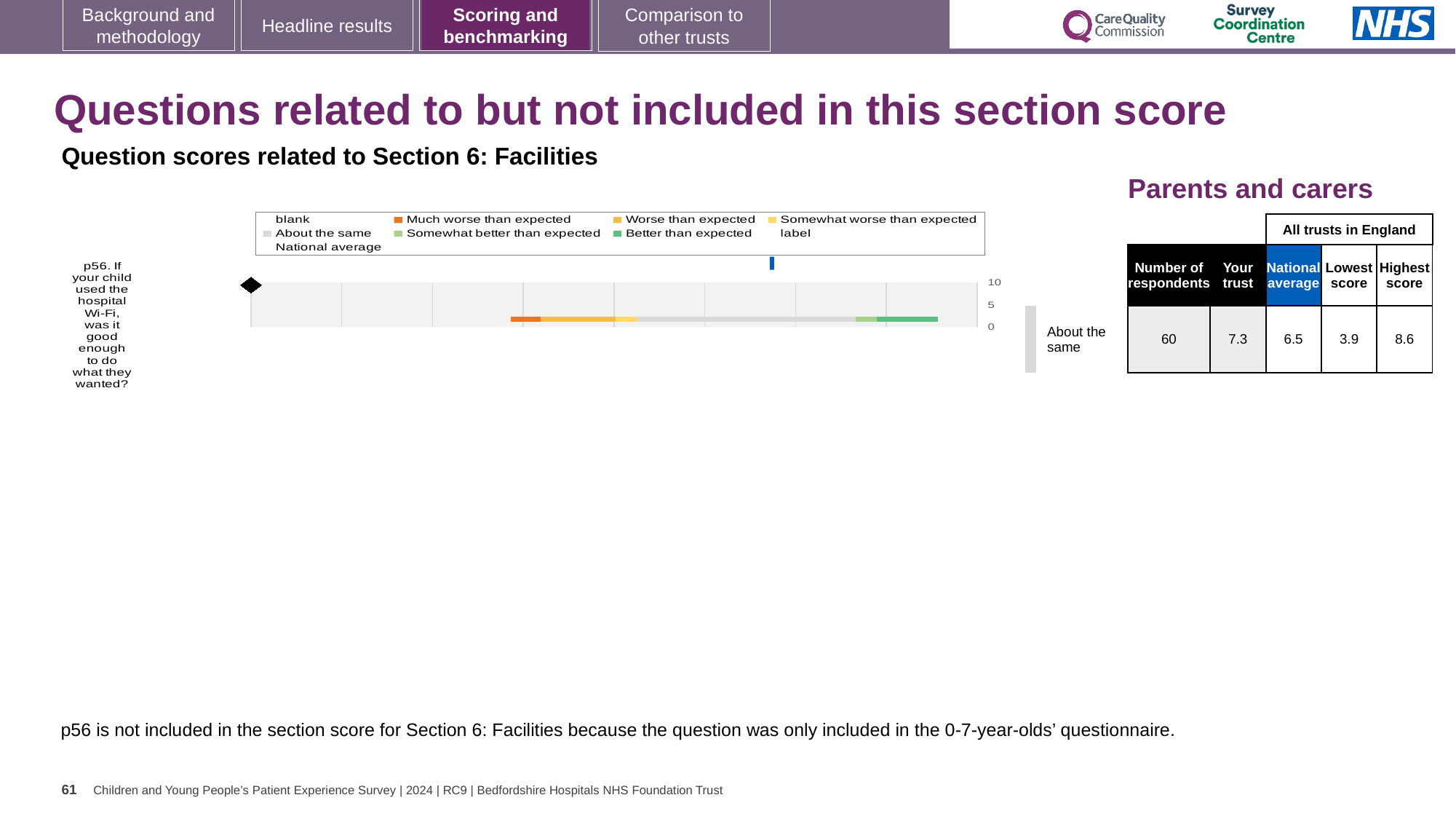
What kind of chart is used to show the p56 question score? bar chart Which benchmark category is the trust's p56 result labelled as? About the same What is the difference between the 'Your trust' score and the national average for p56? 0.8 Which survey question is plotted in the chart? p56. If your child used the hospital Wi-Fi, was it good enough to do what they wanted? What is the difference between the highest and lowest scores for p56? 4.7 Which is larger for p56, the 'Your trust' score or the national average? Your trust What is the highest score among all trusts in England for p56? 8.6 What is the national average score for p56? 6.5 What is the 'Your trust' score for p56? 7.3 What is the lowest score among all trusts in England for p56? 3.9 How many survey questions are plotted in the chart? 1 How many respondents answered p56? 60